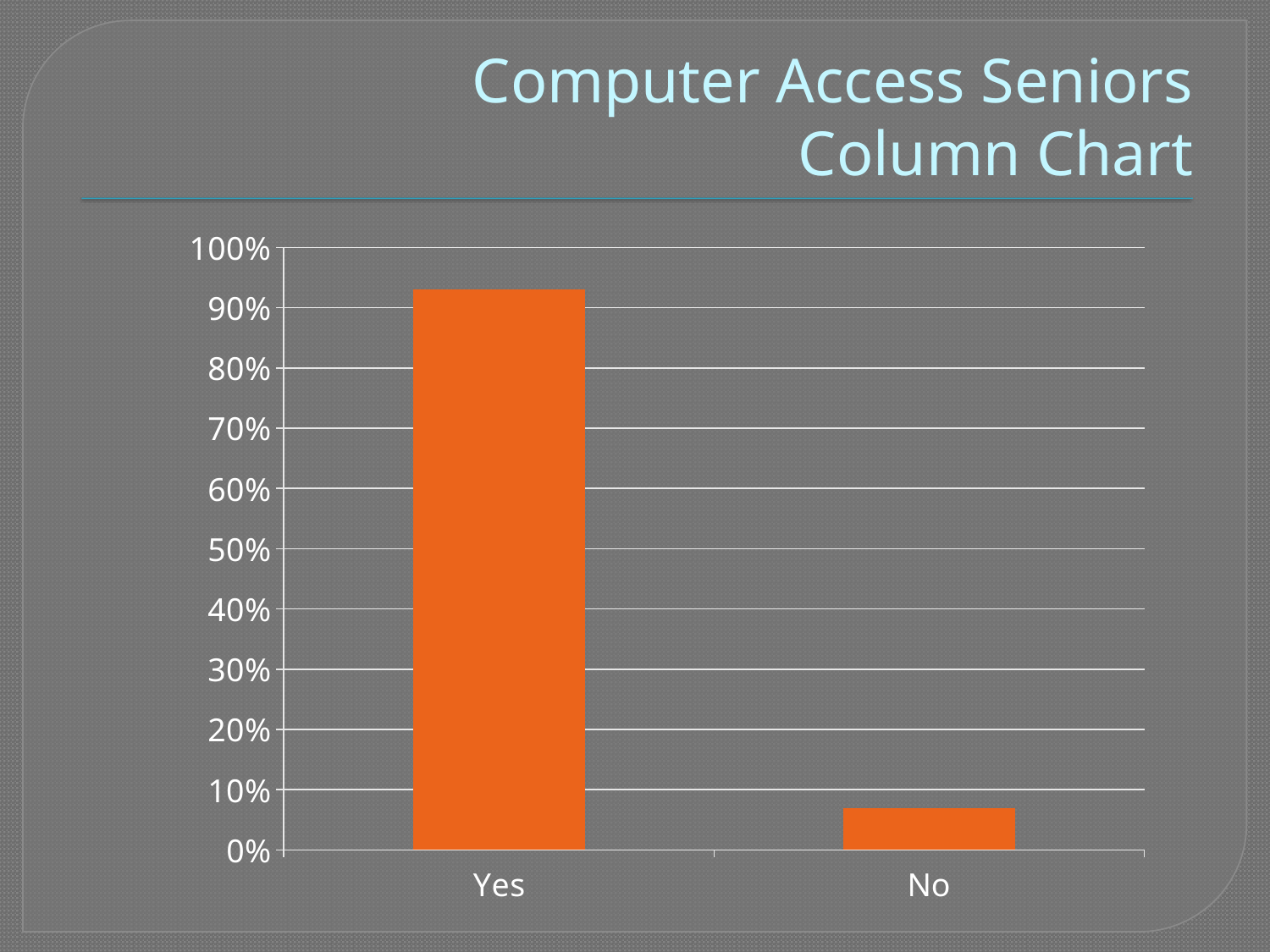
Is the value for No greater or less than 10%? less What is the highest value shown on the y axis? 100% What colour are the bars in the chart? orange How many categories are shown on the x axis? 2 Is the value for Yes greater or less than 90%? greater What kind of chart is shown on the slide? bar chart What is the title of the slide containing the chart? Computer Access Seniors Column Chart Is the value for No greater or less than 20%? less Which category has the lowest value? No Which is larger, the value for Yes or the value for No? Yes Which category has the highest value? Yes